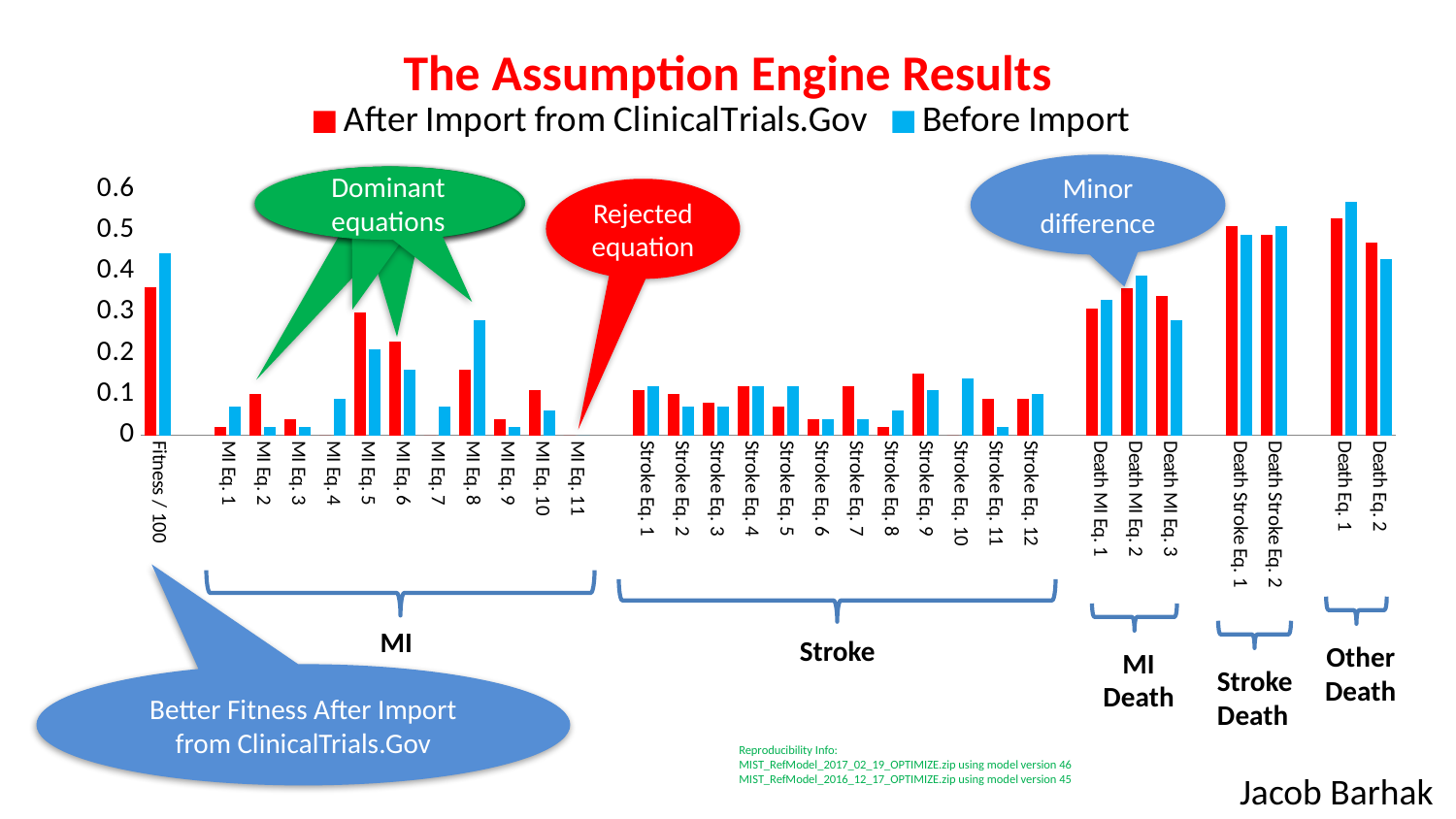
Is the 'Before Import' value for Fitness / 100 greater or less than 0.4? greater Is the 'After Import from ClinicalTrials.Gov' value for Fitness / 100 greater or less than 0.3? greater For MI Eq. 5, which series has the larger value: 'After Import from ClinicalTrials.Gov' or 'Before Import'? After Import from ClinicalTrials.Gov For Fitness / 100, which series has the larger value: 'After Import from ClinicalTrials.Gov' or 'Before Import'? Before Import For MI Eq. 8, which series has the larger value: 'After Import from ClinicalTrials.Gov' or 'Before Import'? Before Import What is the title of the chart? The Assumption Engine Results Which colour represents the 'After Import from ClinicalTrials.Gov' series? red How many Stroke equation categories are plotted on the x axis? 12 What kind of chart is shown on the slide? bar chart Is the 'Before Import' value for Death Eq. 1 greater or less than 0.5? greater How many MI equation categories (MI Eq. 1 through MI Eq. 11) are plotted on the x axis? 11 How many series does the legend list? 2